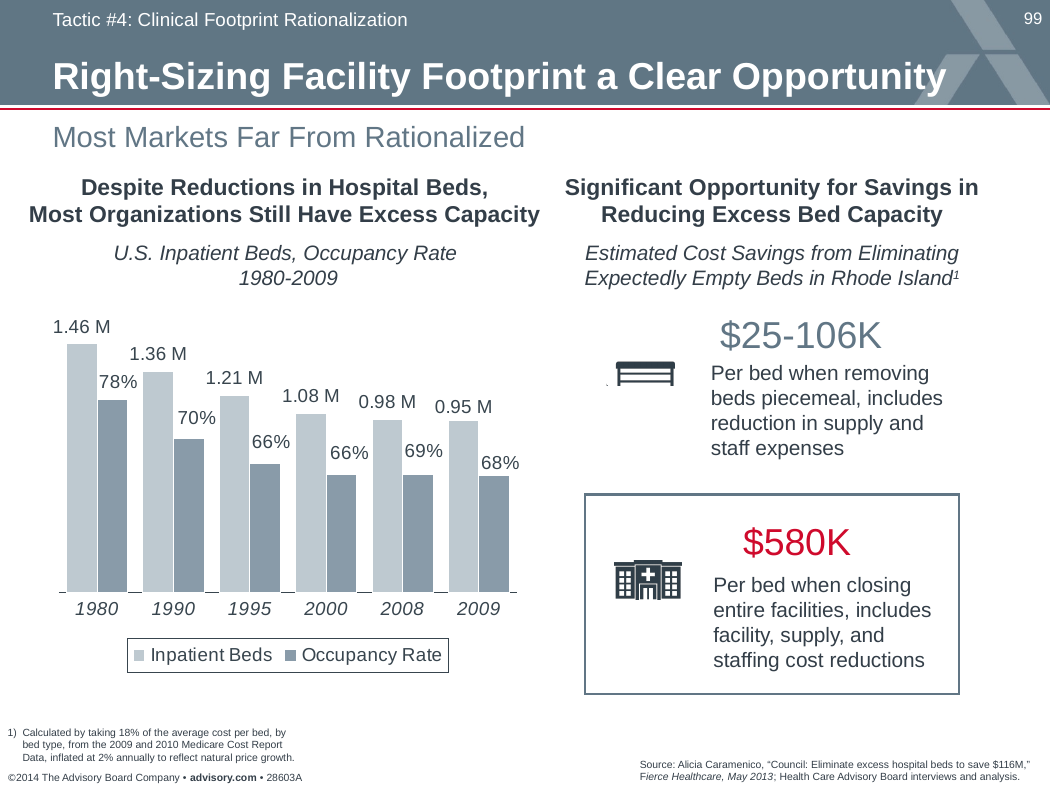
What is the Occupancy Rate for 2008? 69% What is the Occupancy Rate for 1990? 70% Which year has the larger Occupancy Rate, 2008 or 2009? 2008 How many series does the chart legend list? 2 What is the Inpatient Beds value for 2009? 0.95 M How many years are shown on the x axis of the chart? 6 Do the Inpatient Beds values rise or fall from 1980 to 2009? fall Which year has the highest Occupancy Rate? 1980 Which year has the lowest Inpatient Beds value? 2009 What is the Inpatient Beds value for 1980? 1.46 M What is the difference in Occupancy Rate between 1980 and 1995? 12% What is the difference in Inpatient Beds between 1980 and 1990? 0.10 M